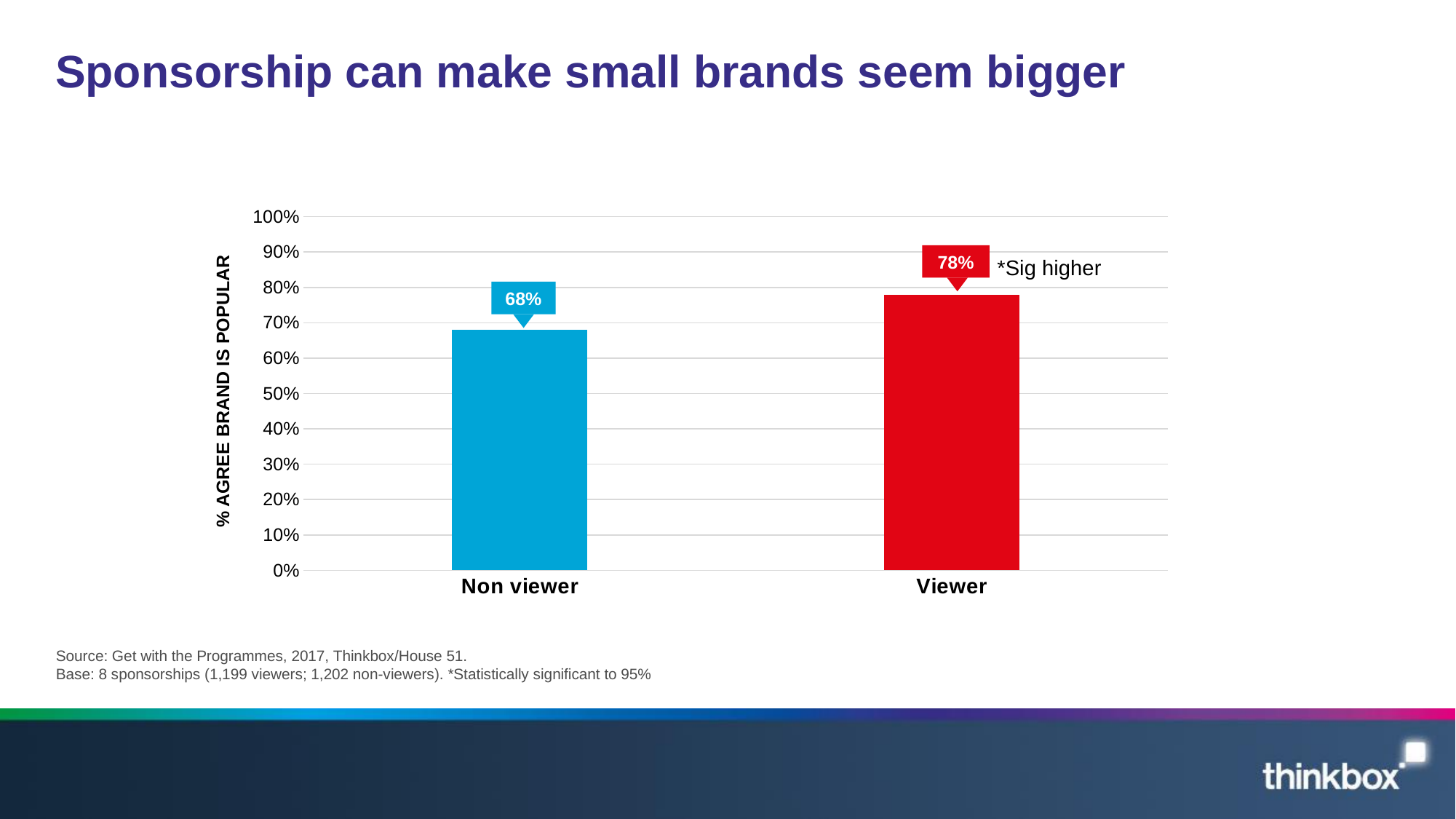
Which category has the higher value, Non viewer or Viewer? Viewer Which category has the lowest value? Non viewer What is the difference in percentage points between the Viewer and Non viewer values? 10 percentage points What is the maximum value shown on the vertical axis? 100% What percentage of viewers agree the brand is popular? 78% Is the value for Viewer greater or less than 70%? greater What kind of chart is shown on the slide? Bar chart What colour is the Viewer bar? Red How many categories are shown on the x axis? 2 Is the value for Non viewer greater or less than 70%? less What percentage of non viewers agree the brand is popular? 68% What is the label of the vertical axis? % AGREE BRAND IS POPULAR